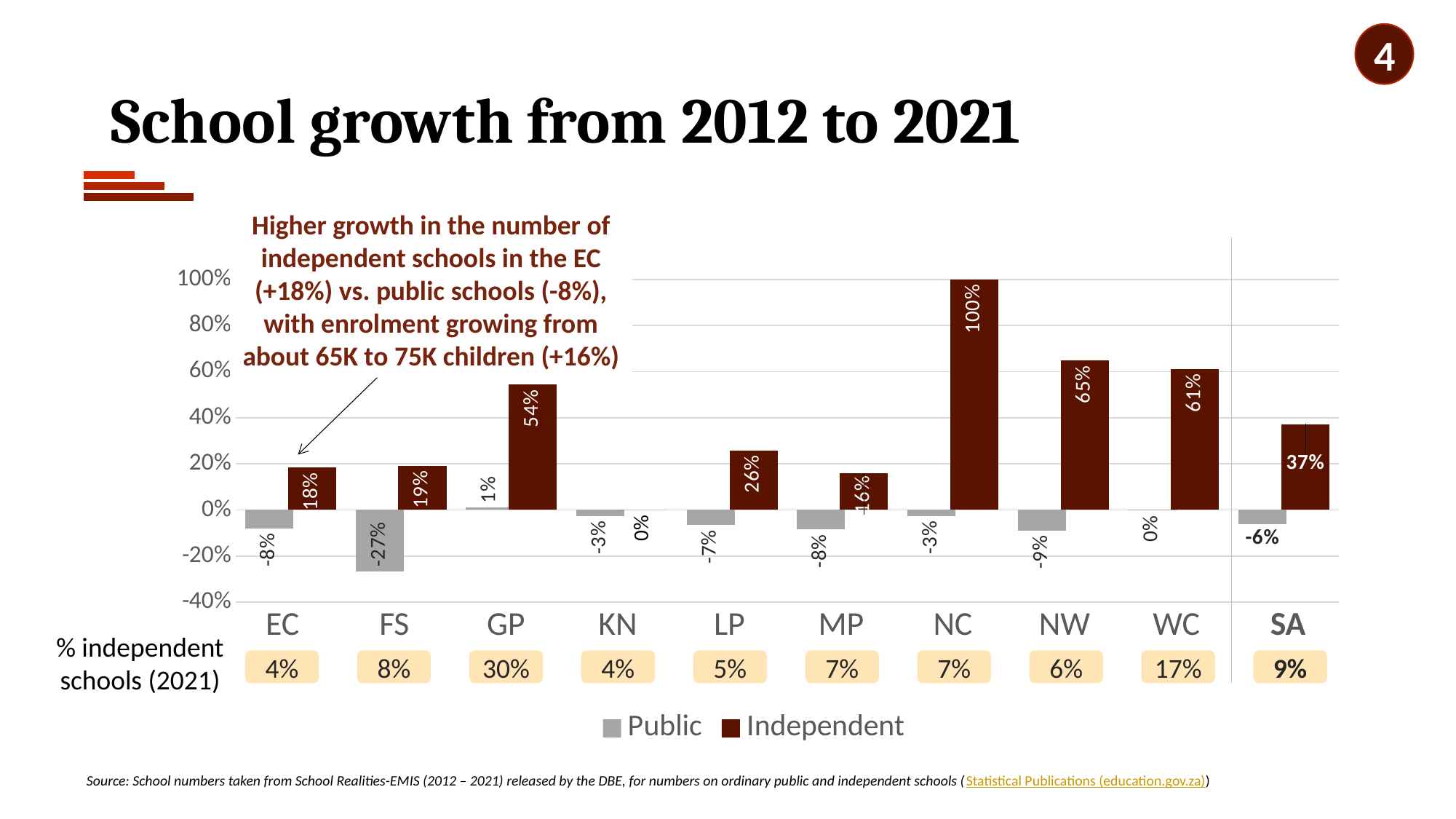
How many categories are shown on the x axis of the chart? 10 What is the difference between the Independent and Public growth values for GP? 53 percentage points Is the Independent growth value for GP greater or less than 40%? greater What is the Independent school growth value for SA? 37% Which has the larger Independent growth value, NW or WC? NW What is the Independent school growth value for NC? 100% How many series does the legend list? 2 What kind of chart is shown on the slide? bar chart Which province has the highest Independent school growth? NC Which category has the lowest Public school growth? FS What are the two series named in the legend? Public and Independent What is the Public school growth value for FS? -27%